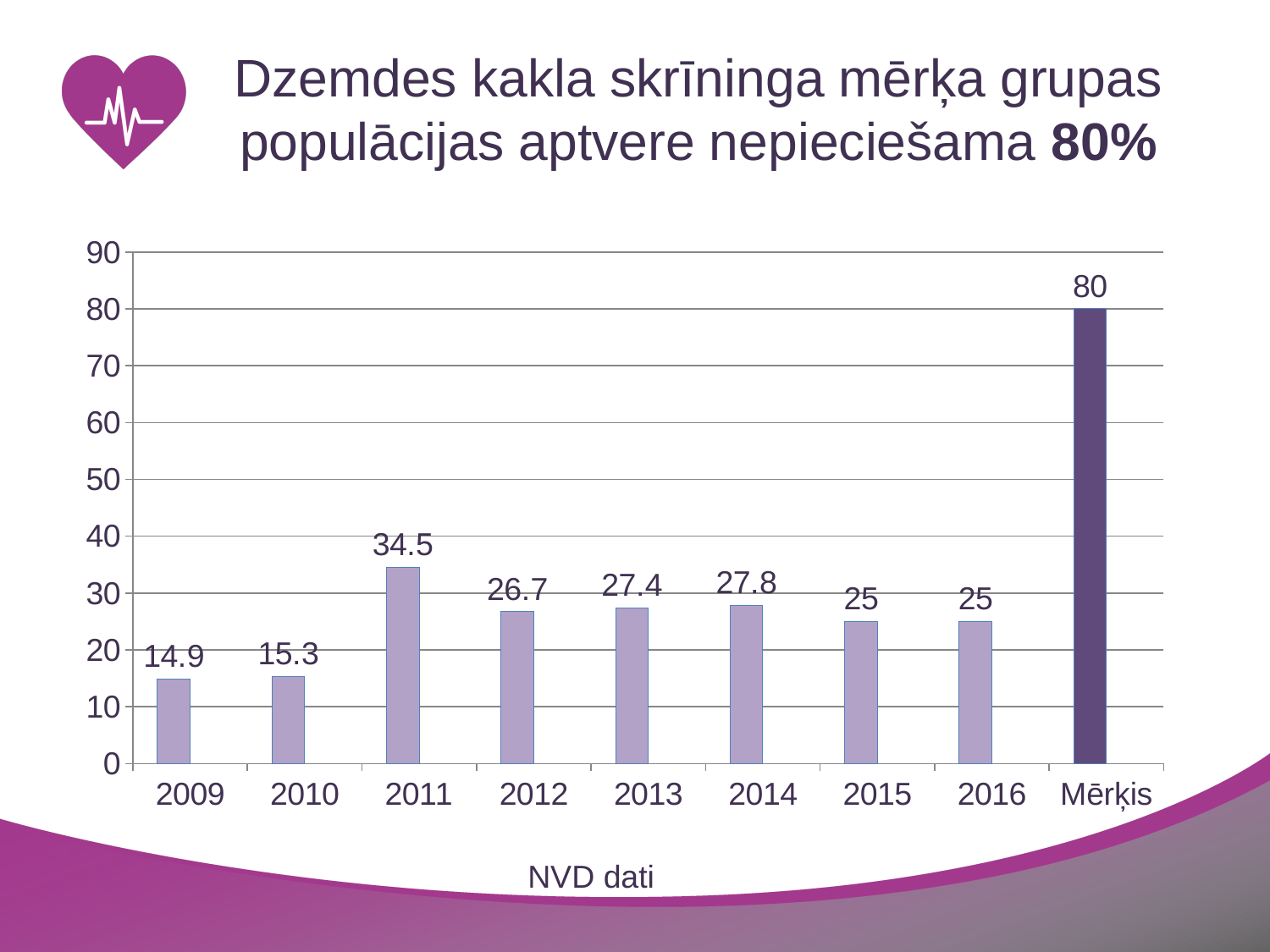
How many categories are shown on the x axis? 9 What kind of chart is shown on the slide? bar chart Which year from 2009 to 2016 has the highest value? 2011 Which category has the lowest value? 2009 What is the value for 2011? 34.5 What is the difference between the value for Mērķis and the value for 2016? 55 What is the value for 2009? 14.9 What text appears below the chart as its source note? NVD dati What is the difference between the values for 2011 and 2012? 7.8 What is the value for Mērķis? 80 Is the value for 2010 greater or less than 20? less Which is larger, the value for 2013 or the value for 2014? 2014